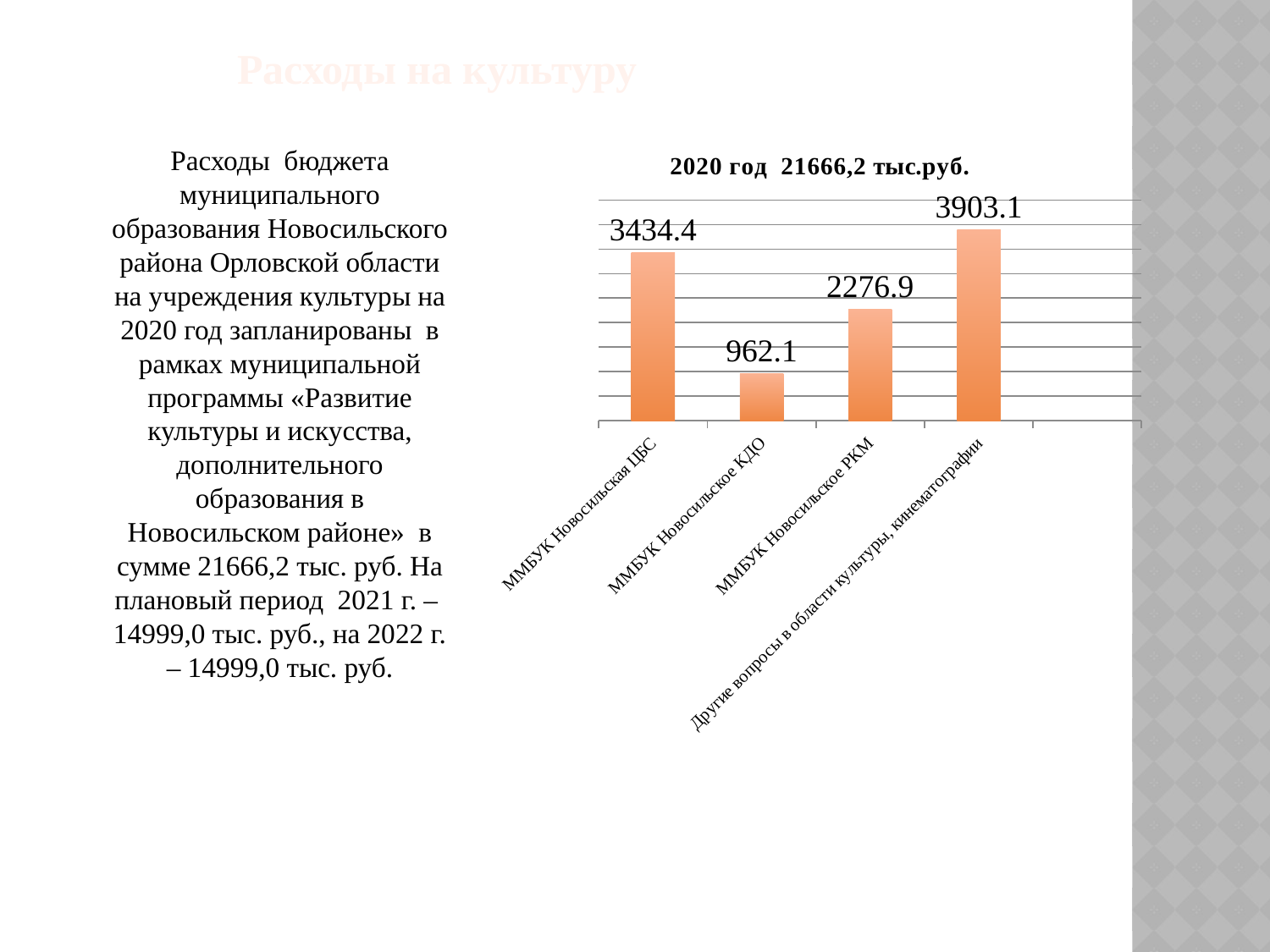
How many categories are shown in the chart? 4 What is the difference between the values for ММБУК Новосильское РКМ and ММБУК Новосильское КДО? 1314.8 What is the value for ММБУК Новосильское КДО? 962.1 Which is larger, the value for ММБУК Новосильская ЦБС or the value for ММБУК Новосильское РКМ? ММБУК Новосильская ЦБС Which category has the highest value? Другие вопросы в области культуры, кинематографии What is the difference between the values for Другие вопросы в области культуры, кинематографии and ММБУК Новосильская ЦБС? 468.7 What is the value for ММБУК Новосильское РКМ? 2276.9 What is the value for Другие вопросы в области культуры, кинематографии? 3903.1 What kind of chart is shown on the slide? Bar chart What is the title of the chart? 2020 год 21666,2 тыс.руб. What is the value for ММБУК Новосильская ЦБС? 3434.4 Which category has the lowest value? ММБУК Новосильское КДО